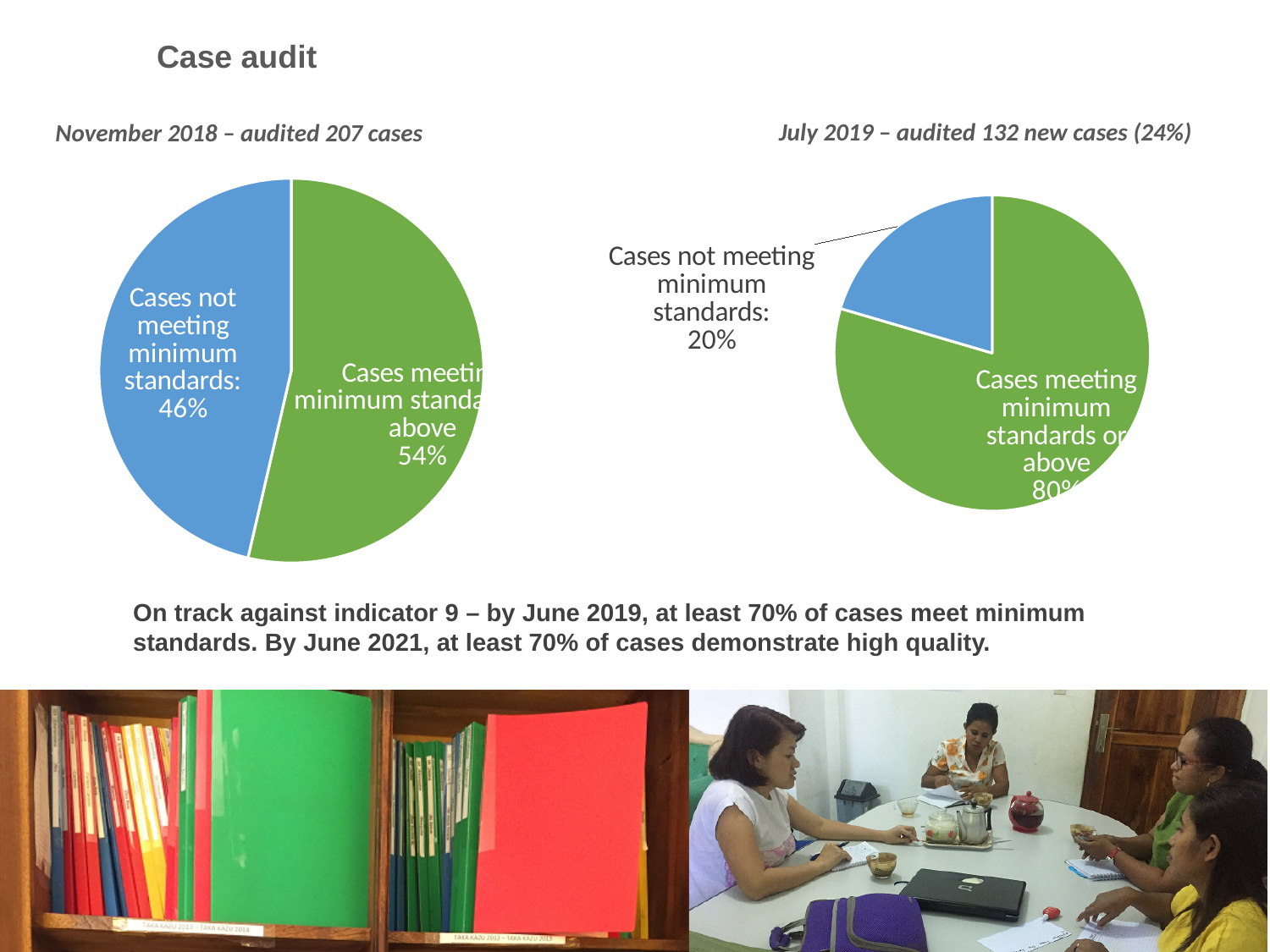
In the November 2018 pie chart, which slice is larger: cases meeting minimum standards or above, or cases not meeting minimum standards? Cases meeting minimum standards or above In the November 2018 pie chart, what share of cases were not meeting minimum standards? 46% In the July 2019 pie chart, what colour is the slice for cases not meeting minimum standards? Blue How many slices does the November 2018 pie chart have? 2 Did the share of cases meeting minimum standards or above rise or fall from November 2018 to July 2019? Rise In the July 2019 pie chart, which category has the smallest slice? Cases not meeting minimum standards In the July 2019 pie chart, what share of cases were meeting minimum standards or above? 80% What kind of chart is used for the November 2018 case audit? Pie chart What is the difference between the share of cases not meeting minimum standards in November 2018 and in July 2019? 26 percentage points How many cases were audited in November 2018 according to the chart heading? 207 In the November 2018 pie chart, what share of cases were meeting minimum standards or above? 54%